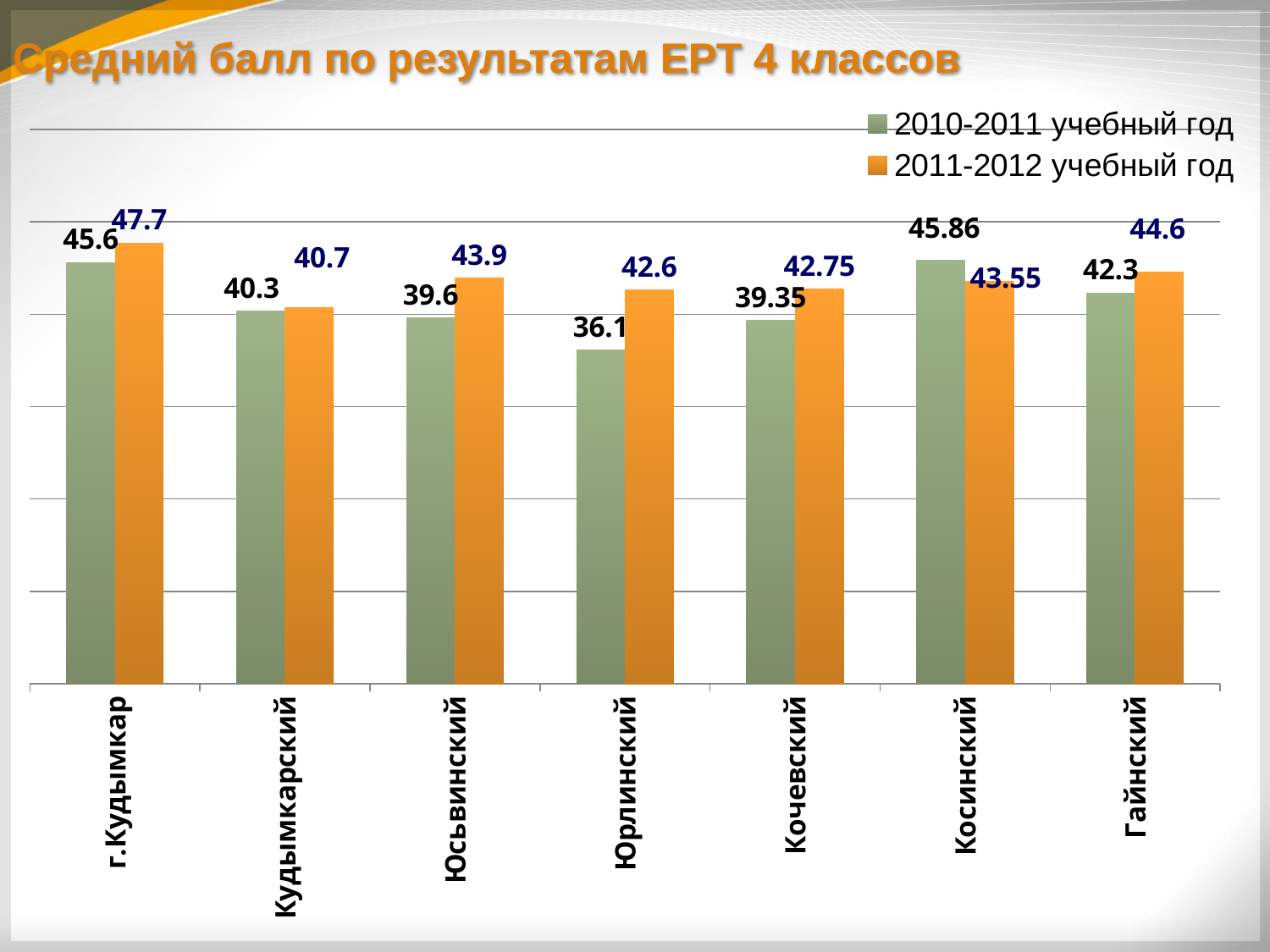
Which category has the lowest value in the 2010-2011 учебный год series? Юрлинский What is the difference between the 2011-2012 and 2010-2011 values for Юрлинский? 6.5 What is the difference between the 2010-2011 and 2011-2012 values for Косинский? 2.31 What is the value for Косинский in the 2010-2011 учебный год series? 45.86 What is the title of the chart? Средний балл по результатам ЕРТ 4 классов What kind of chart is shown on the slide? Bar chart How many series does the legend list? 2 For Косинский, which series has the larger value: 2010-2011 учебный год or 2011-2012 учебный год? 2010-2011 учебный год How many categories are shown on the x axis? 7 What is the value for Кочевский in the 2011-2012 учебный год series? 42.75 Which category has the highest value in the 2011-2012 учебный год series? г.Кудымкар What is the value for Юрлинский in the 2010-2011 учебный год series? 36.1